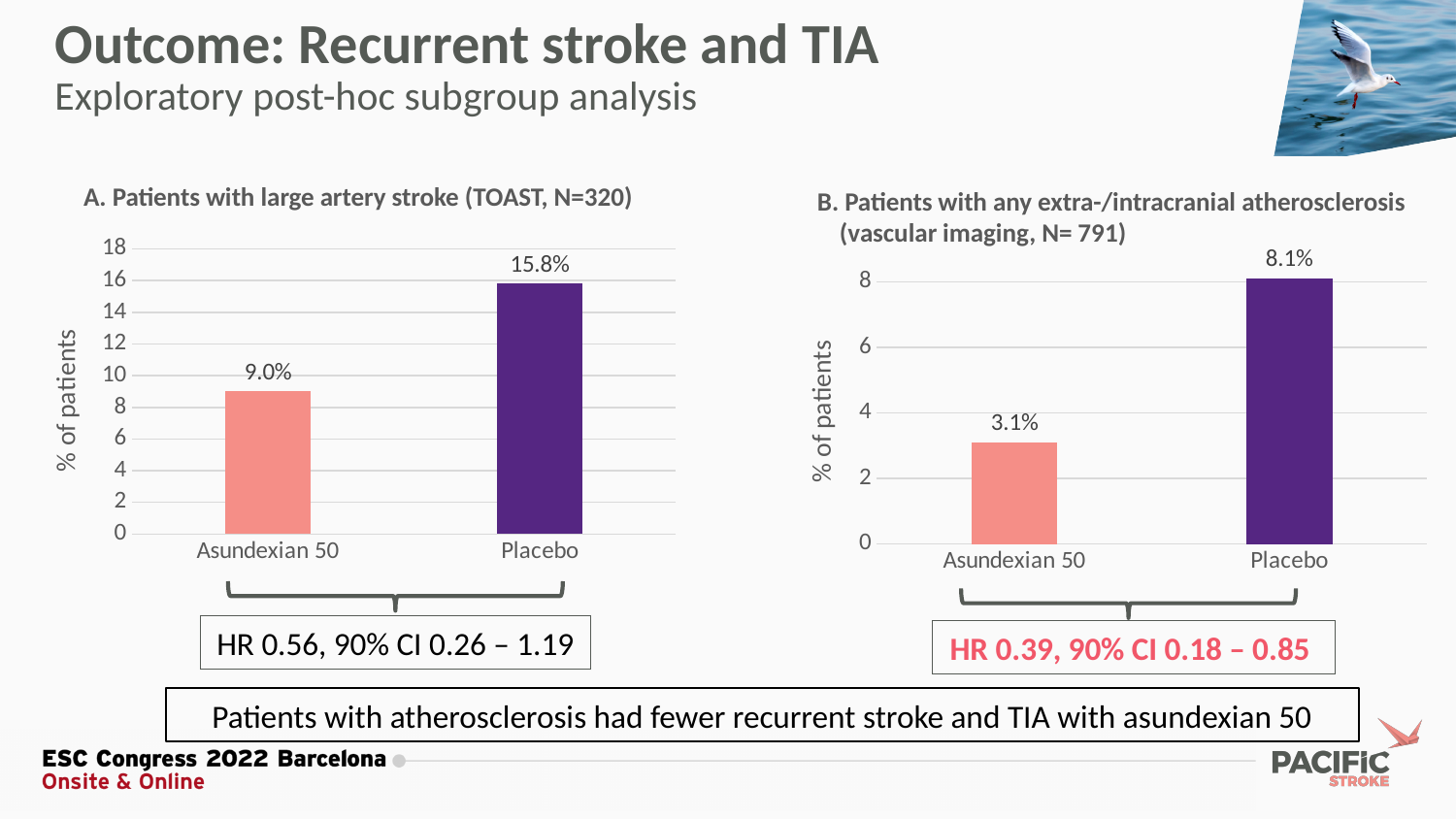
What is the y-axis label of chart A (Patients with large artery stroke)? % of patients In chart A (Patients with large artery stroke), what is the value for Placebo? 15.8% In chart B (Patients with any extra-/intracranial atherosclerosis), what is the value for Placebo? 8.1% In chart A (Patients with large artery stroke), what is the value for Asundexian 50? 9.0% In chart B (Patients with any extra-/intracranial atherosclerosis), what is the value for Asundexian 50? 3.1% In chart A (Patients with large artery stroke), which group has the higher percentage of patients? Placebo What kind of chart is chart B (Patients with any extra-/intracranial atherosclerosis)? Bar chart In chart A (Patients with large artery stroke), what is the difference between the Placebo and Asundexian 50 values? 6.8% How many categories are shown on the x axis of chart A (Patients with large artery stroke)? 2 In chart B (Patients with any extra-/intracranial atherosclerosis), is the value for Placebo greater or less than 6? greater In chart B (Patients with any extra-/intracranial atherosclerosis), which group has the lower percentage of patients? Asundexian 50 In chart B (Patients with any extra-/intracranial atherosclerosis), what is the difference between the Placebo and Asundexian 50 values? 5.0%